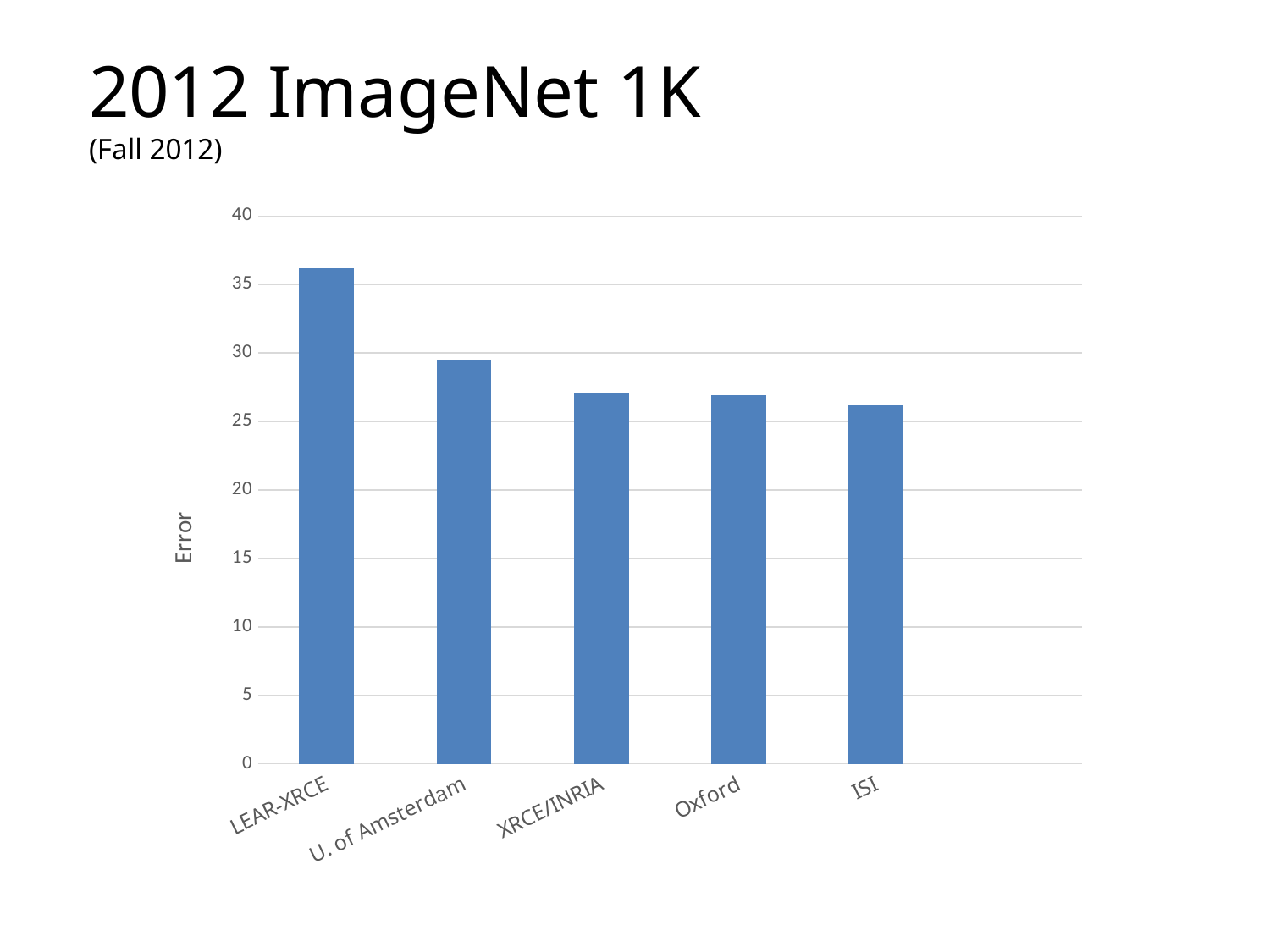
Is the error value for XRCE/INRIA greater or less than 25? greater Do the error values rise or fall moving from left to right along the x axis? fall Is the error value for Oxford greater or less than 30? less Which team has the highest error in the chart? LEAR-XRCE Which has a larger error, U. of Amsterdam or ISI? U. of Amsterdam Is the error value for U. of Amsterdam greater or less than 30? less What is the label on the vertical axis of the chart? Error How many categories (teams) are shown on the x axis of the chart? 5 What kind of chart is shown on the slide? bar chart Which has a larger error, LEAR-XRCE or U. of Amsterdam? LEAR-XRCE